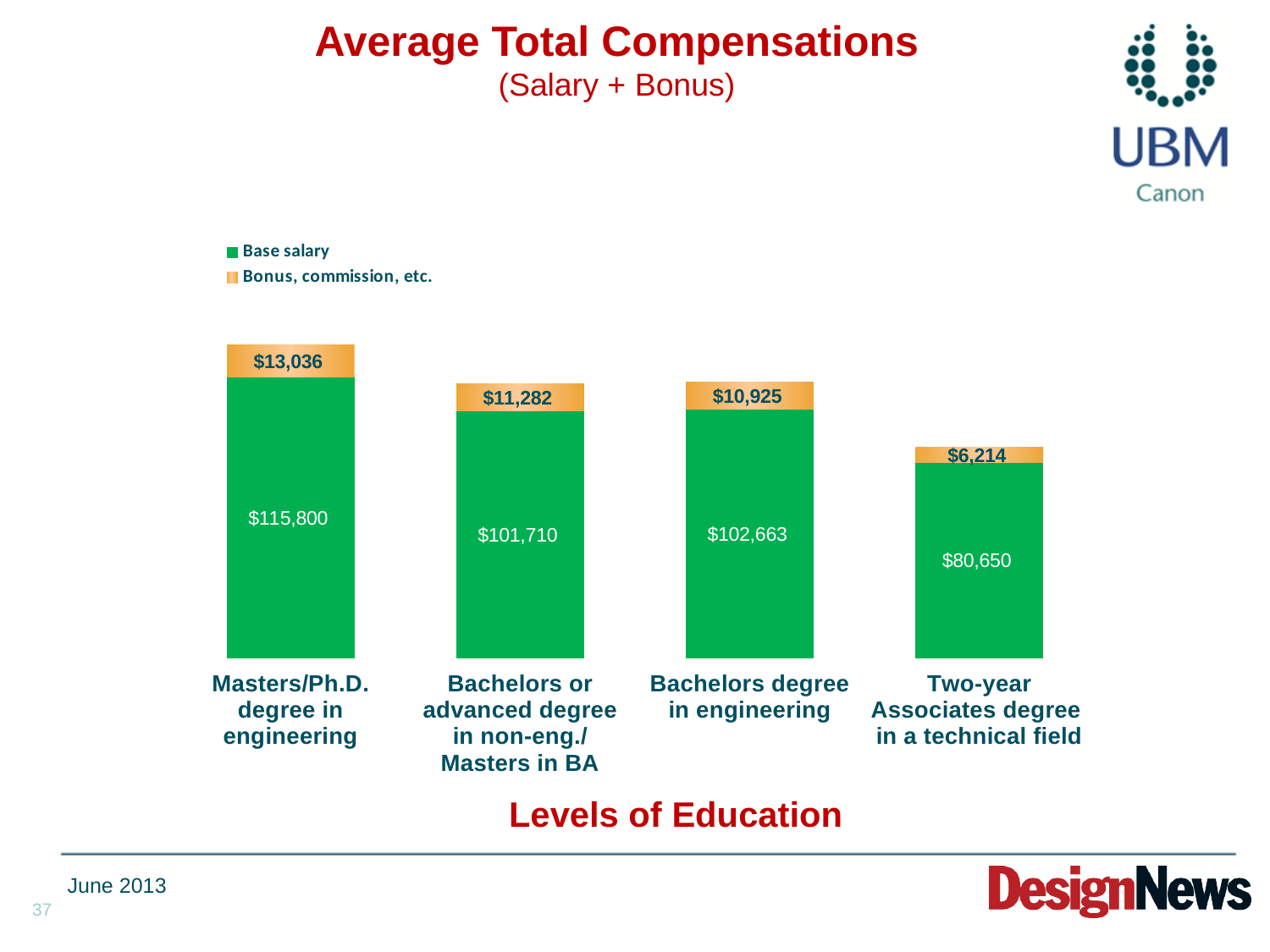
Which level of education has the highest base salary? Masters/Ph.D. degree in engineering How many levels of education are shown on the chart? 4 What is the total compensation (base salary plus bonus) for the Two-year Associates degree in a technical field bar? $86,864 What is the bonus, commission, etc. value for the Two-year Associates degree in a technical field category? $6,214 How many series does the legend list? 2 What is the total compensation (base salary plus bonus) for the Masters/Ph.D. degree in engineering bar? $128,836 Which level of education has the lowest bonus, commission, etc. value? Two-year Associates degree in a technical field What is the difference in base salary between the Masters/Ph.D. degree in engineering and the Two-year Associates degree in a technical field? $35,150 What is the base salary for the Masters/Ph.D. degree in engineering category? $115,800 Which has the larger base salary: Bachelors degree in engineering or Bachelors or advanced degree in non-eng./Masters in BA? Bachelors degree in engineering What is the base salary for the Bachelors degree in engineering category? $102,663 What kind of chart is shown on the slide? Stacked bar chart